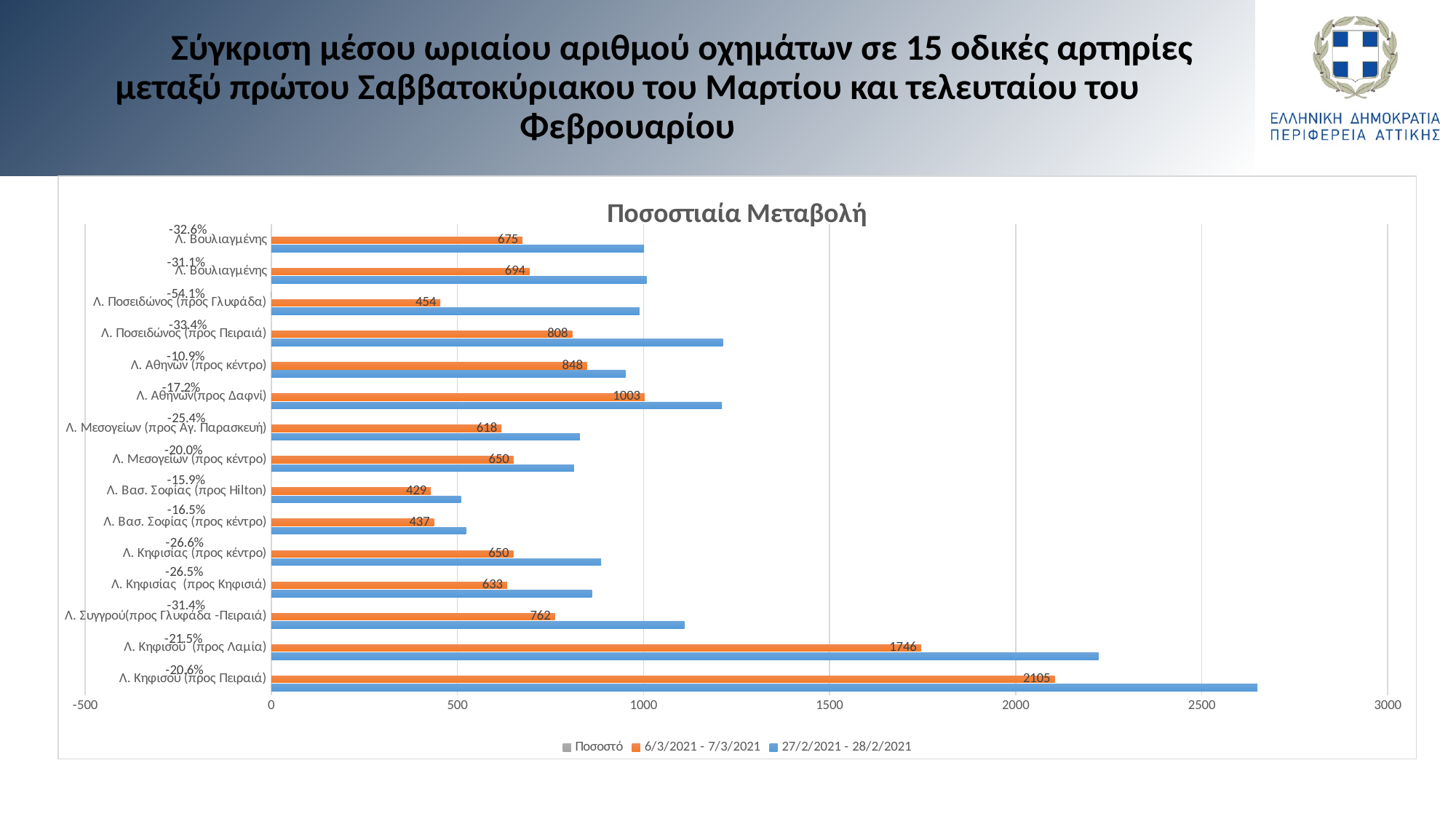
What is the value for Λ. Κηφισού (προς Λαμία) in the 6/3/2021 - 7/3/2021 series? 1746 What is the difference between the 6/3/2021 - 7/3/2021 values for Λ. Κηφισού (προς Πειραιά) and Λ. Κηφισού (προς Λαμία)? 359 What type of chart is shown on the slide? bar chart Is the 27/2/2021 - 28/2/2021 value for Λ. Κηφισού (προς Πειραιά) greater or less than 2500? greater Which category has the lowest value in the 6/3/2021 - 7/3/2021 series? Λ. Βασ. Σοφίας (προς Hilton) Which category has the highest value in the 6/3/2021 - 7/3/2021 series? Λ. Κηφισού (προς Πειραιά) What is the title of the chart? Ποσοστιαία Μεταβολή What is the value for Λ. Ποσειδώνος (προς Γλυφάδα) in the 6/3/2021 - 7/3/2021 series? 454 What percentage change is shown for Λ. Αθηνών (προς κέντρο)? -10.9% How many road arteries (categories) are plotted on the chart? 15 What percentage change is shown for Λ. Ποσειδώνος (προς Γλυφάδα)? -54.1% How many series does the legend list? 3